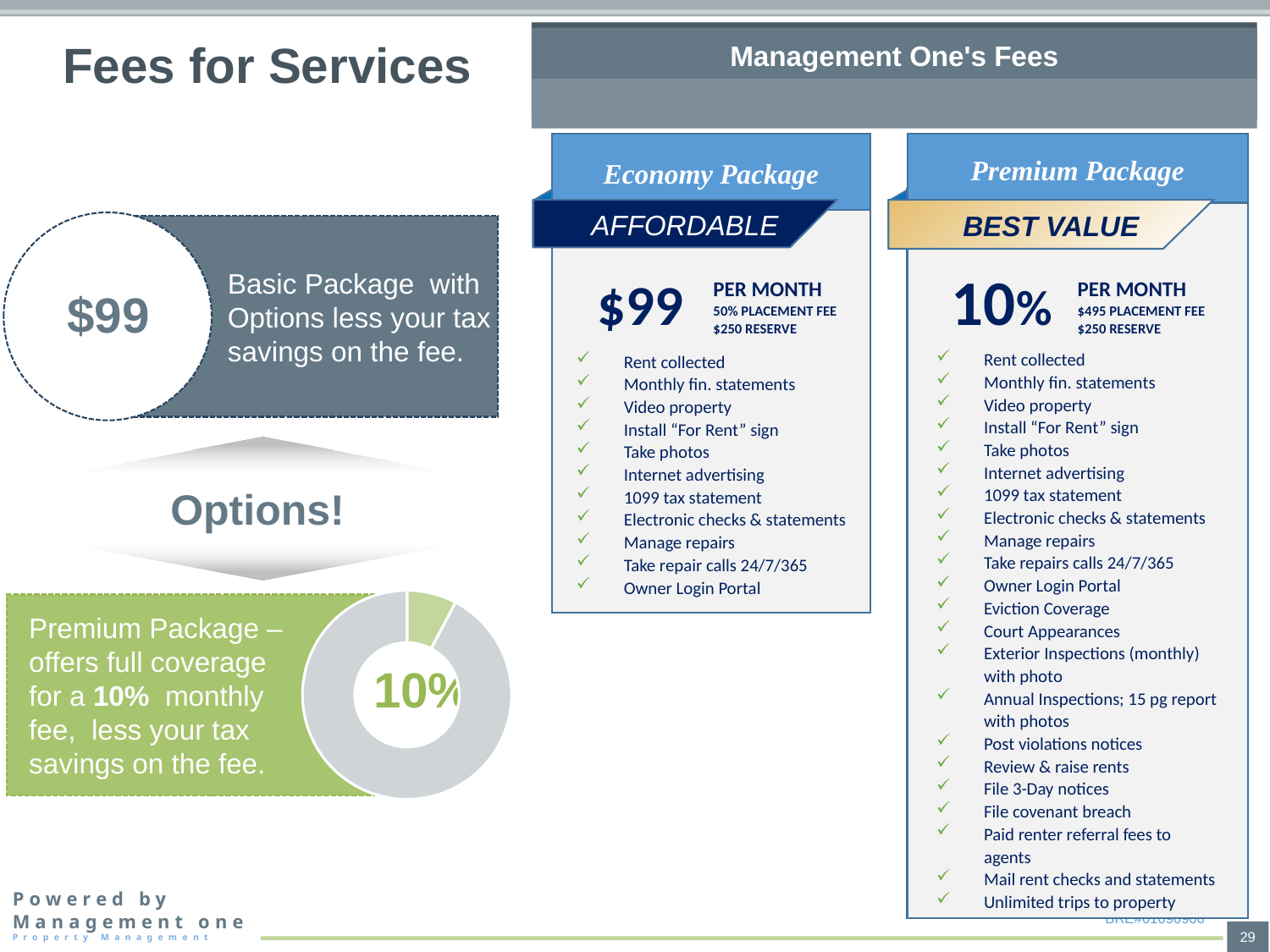
What value is printed in the centre of the doughnut chart at the bottom left of the slide? 10% Does the doughnut chart at the bottom left of the slide show a legend? No In the doughnut chart at the bottom left of the slide, which slice is larger, the grey one or the green one? The grey one How many slices does the doughnut chart at the bottom left of the slide have? 2 In the doughnut chart at the bottom left of the slide, which colour slice is the smallest? Green What monthly fee does the doughnut chart at the bottom left of the slide illustrate for the Premium Package? 10% In the doughnut chart at the bottom left of the slide, which colour slice is the largest? Grey What kind of chart is shown at the bottom left of the slide? Doughnut (pie) chart